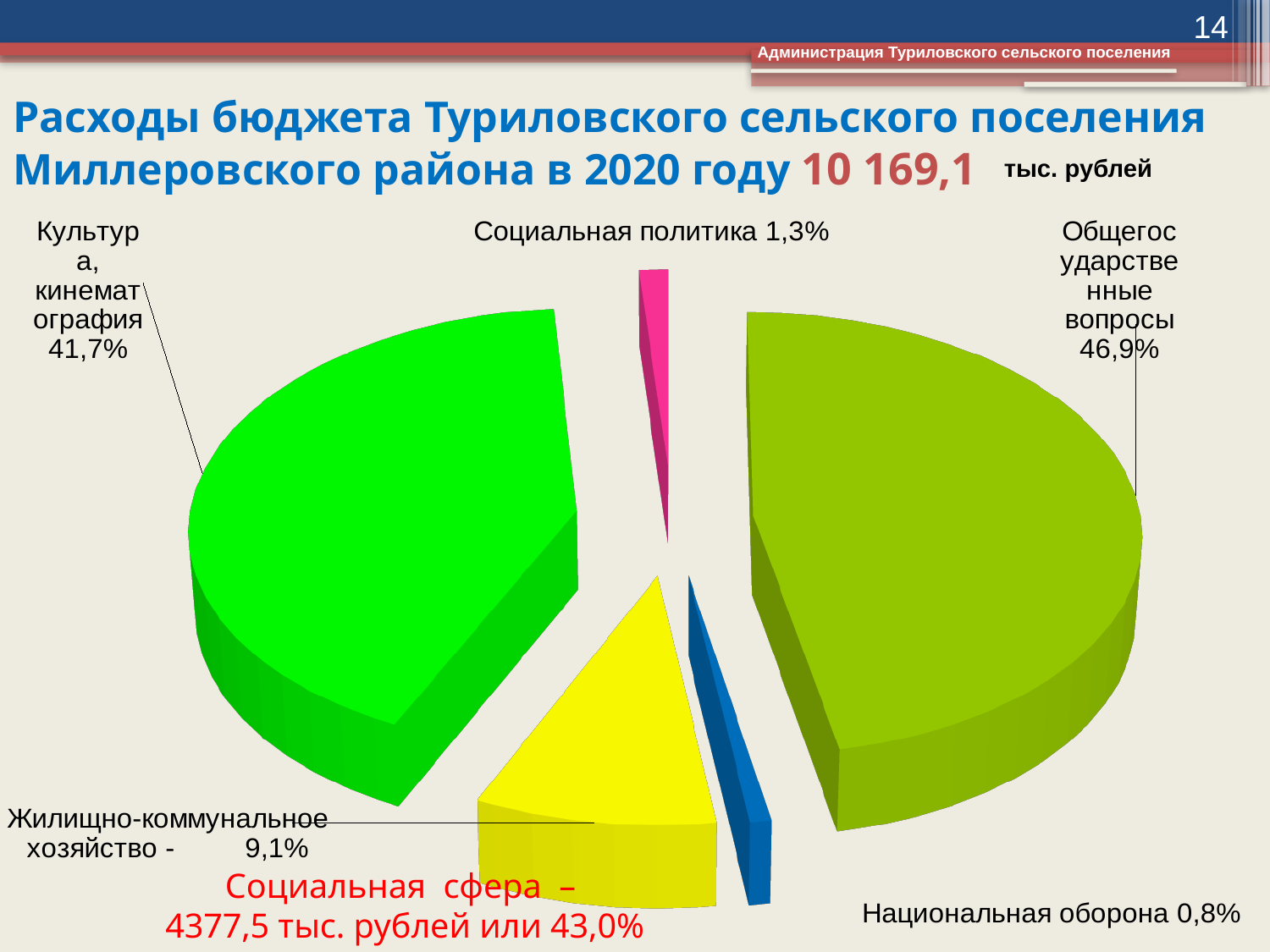
What total budget expenditure amount (in тыс. рублей) is stated in the slide title? 10 169,1 Which category has the smallest share of the pie? Национальная оборона What share of the pie does Социальная политика have? 1,3% How many slices does the pie chart have? 5 What share of the pie does Национальная оборона have? 0,8% What is the difference in percentage points between Общегосударственные вопросы and Культура, кинематография? 5,2 What share of the pie does Жилищно-коммунальное хозяйство have? 9,1% Which is larger: the share for Жилищно-коммунальное хозяйство or the share for Социальная политика? Жилищно-коммунальное хозяйство What kind of chart is shown on the slide? pie chart Which category has the largest share of the pie? Общегосударственные вопросы